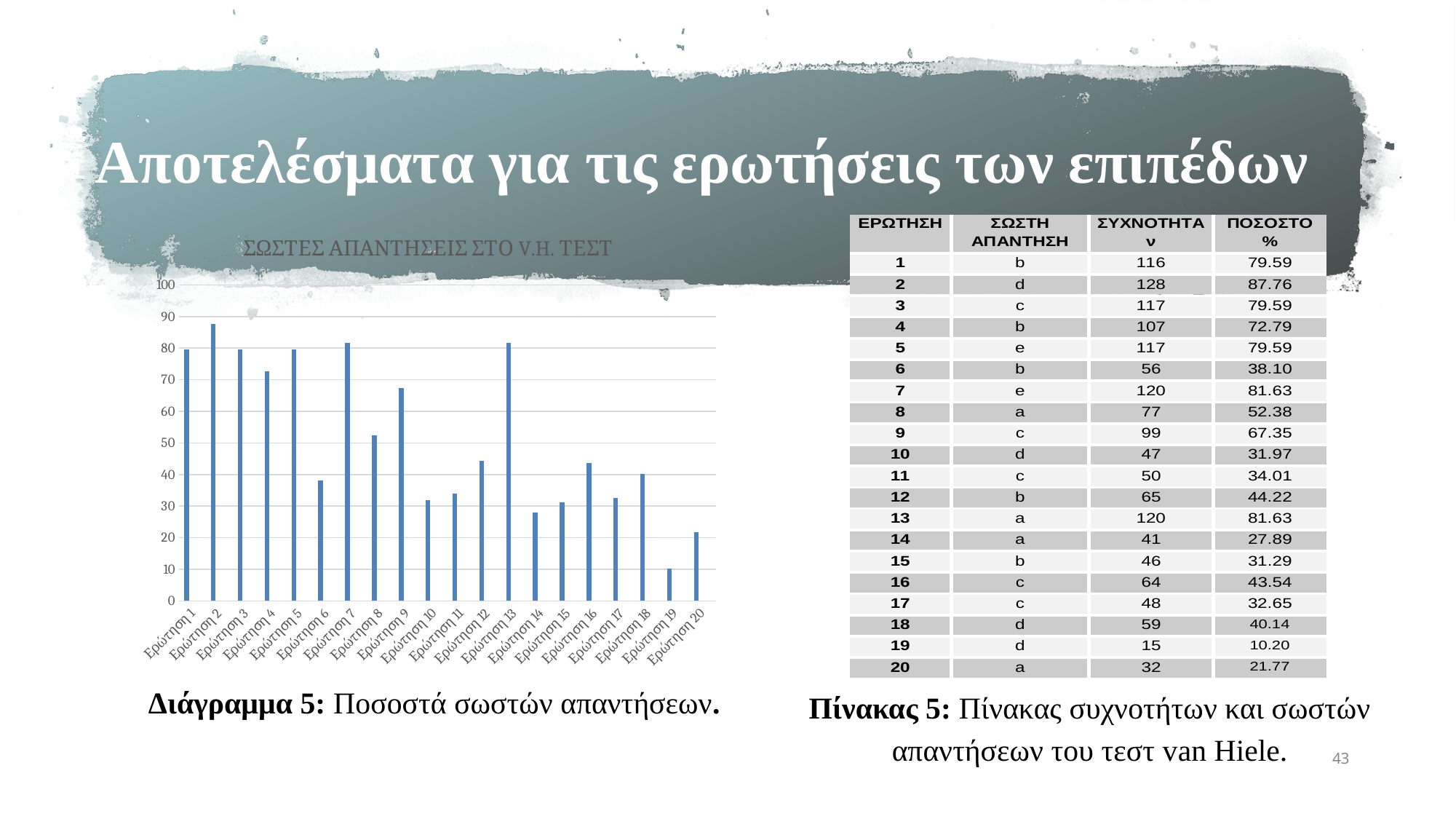
In the bar chart, which is larger, the value for Ερώτηση 16 or Ερώτηση 17? Ερώτηση 16 In the bar chart, which is larger, the value for Ερώτηση 2 or Ερώτηση 6? Ερώτηση 2 Which question has the lowest bar in the chart? Ερώτηση 19 In the bar chart, is the value for Ερώτηση 9 greater or less than 60? greater In the bar chart, is the value for Ερώτηση 14 greater or less than 30? less In the bar chart, is the value for Ερώτηση 6 greater or less than 40? less Which question has the highest bar in the chart? Ερώτηση 2 How many questions (categories) are plotted in the bar chart? 20 What is the title of the bar chart? ΣΩΣΤΕΣ ΑΠΑΝΤΗΣΕΙΣ ΣΤΟ V.H. ΤΕΣΤ What kind of chart is shown on the left of the slide? bar chart What is the caption label given below the bar chart? Διάγραμμα 5: Ποσοστά σωστών απαντήσεων.